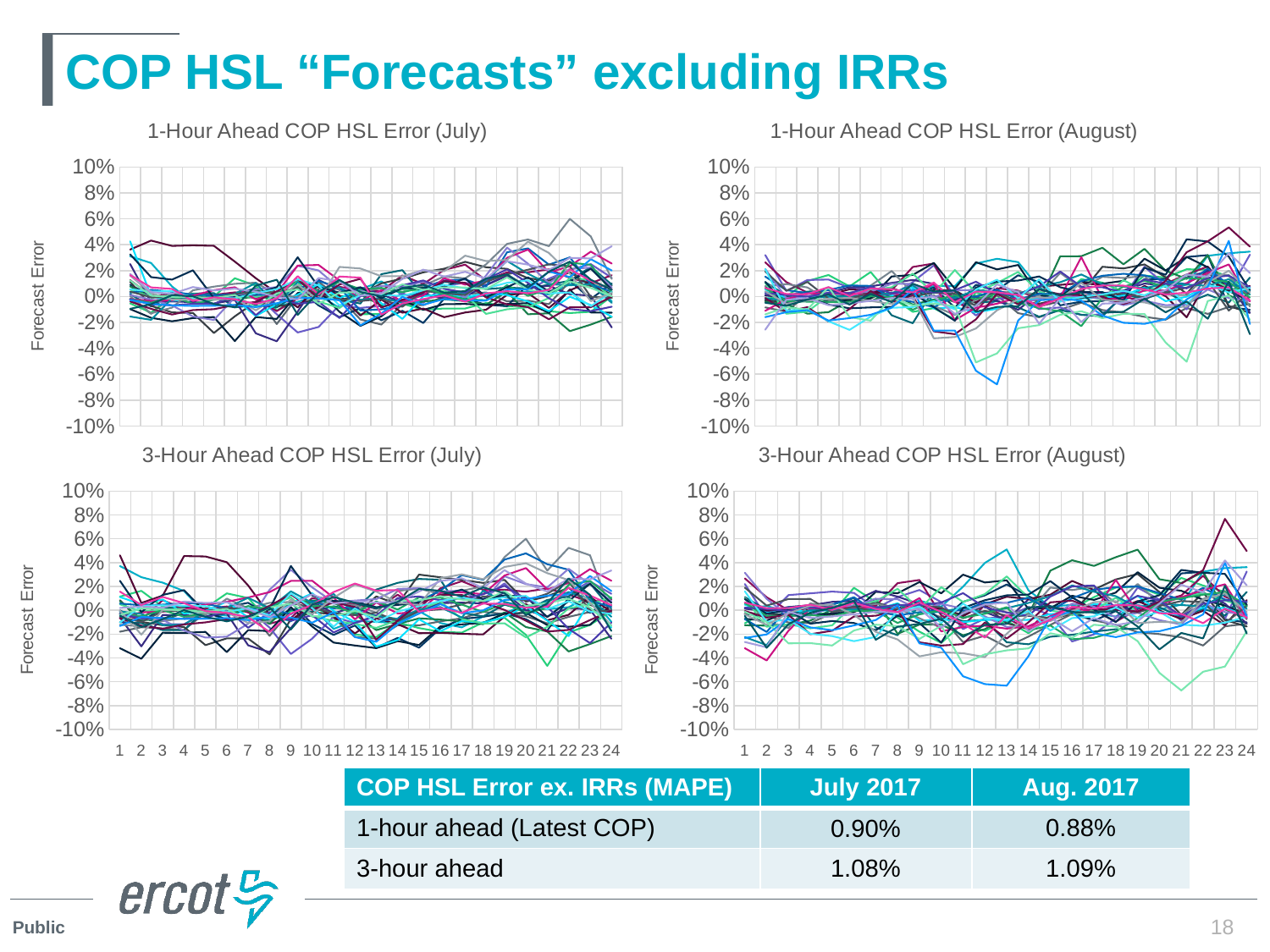
What kind of chart is the '1-Hour Ahead COP HSL Error (July)' chart? line chart In the '1-Hour Ahead COP HSL Error (July)' chart, is the lowest value reached by any line greater or less than -6%? greater How many hours are shown on the x axis of the '3-Hour Ahead COP HSL Error (August)' chart? 24 In the '3-Hour Ahead COP HSL Error (August)' chart, is the highest value reached by any line greater or less than 6%? greater What kind of chart is the '3-Hour Ahead COP HSL Error (August)' chart? line chart In the '1-Hour Ahead COP HSL Error (July)' chart, is the highest value reached by any line greater or less than 8%? less How many charts are shown on the slide? 4 What is the y-axis label on the '3-Hour Ahead COP HSL Error (July)' chart? Forecast Error